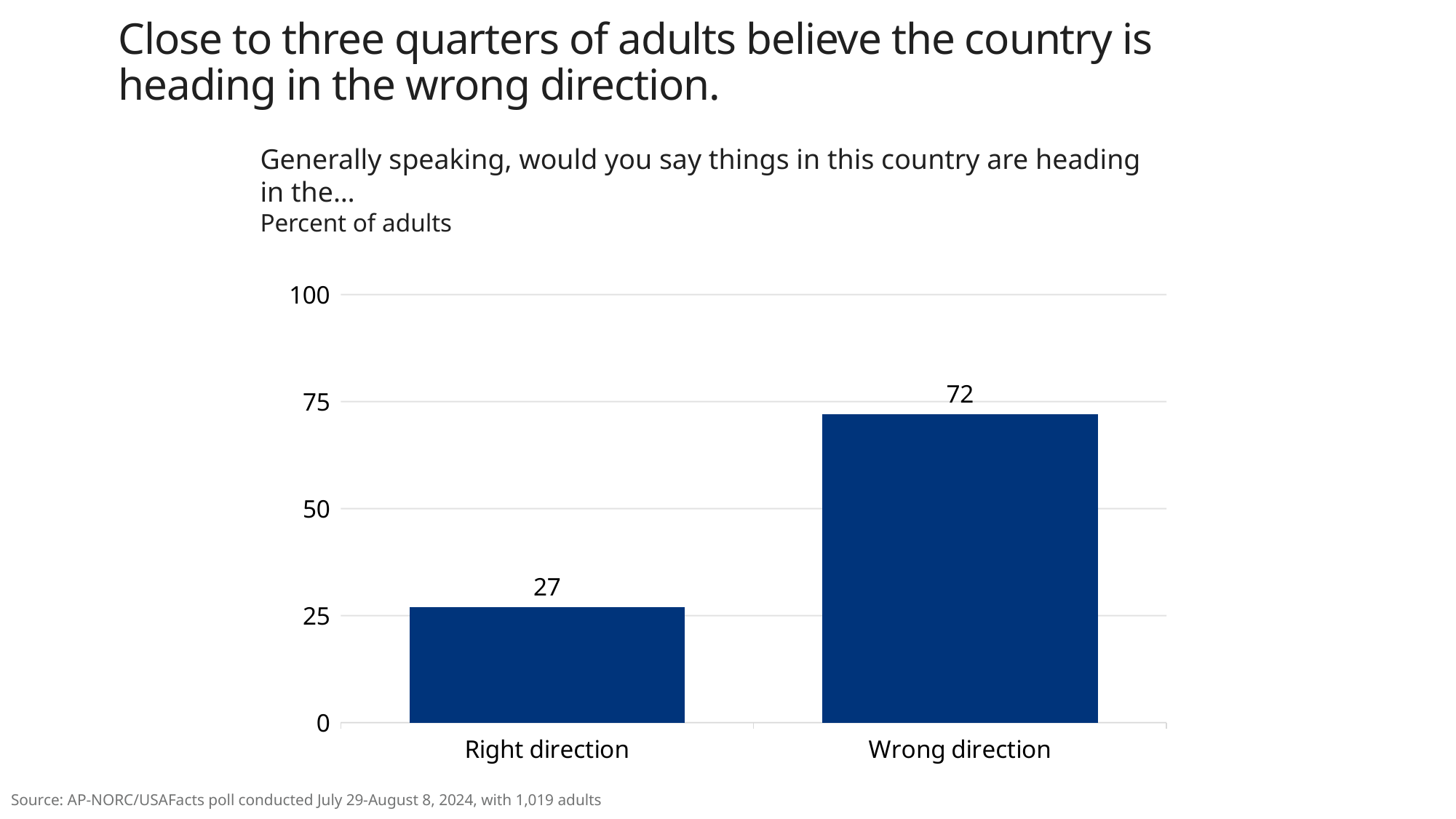
What kind of chart is shown on the slide? Bar chart How many categories are shown in the chart? 2 Is the value for Right direction greater or less than 50? less Which category has the lowest value? Right direction What is the difference between the values for Wrong direction and Right direction? 45 What unit does the chart subtitle say the values are in? Percent of adults Which category has the highest value? Wrong direction What is the highest value shown on the vertical axis? 100 What is the value for Wrong direction? 72 What is the value for Right direction? 27 Is the value for Wrong direction greater or less than 50? greater Which is larger, the value for Right direction or the value for Wrong direction? Wrong direction